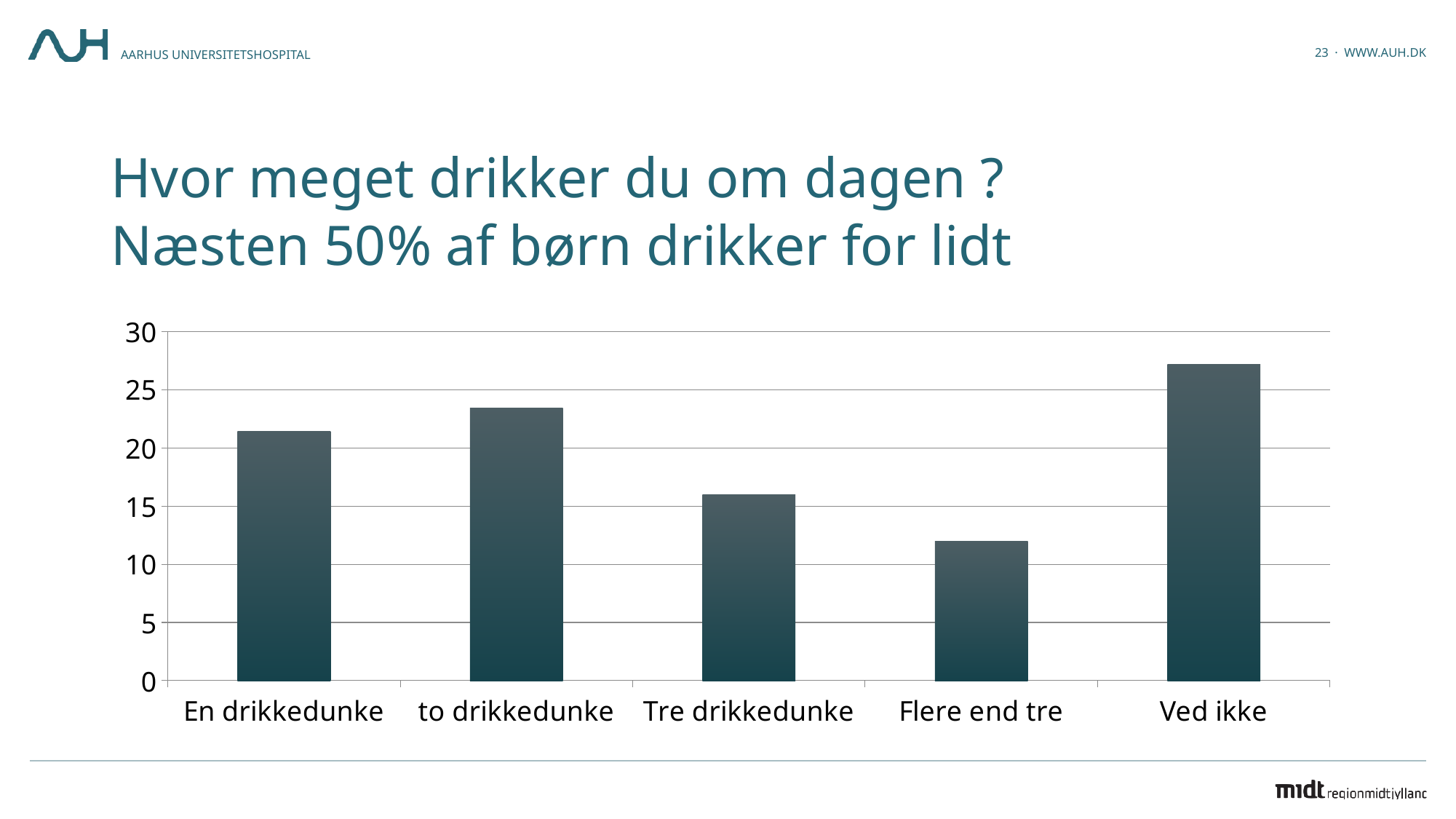
Is the value for Tre drikkedunke greater or less than 20? less Which is larger, the value for Tre drikkedunke or the value for Flere end tre? Tre drikkedunke Is the value for to drikkedunke greater or less than 25? less Which is larger, the value for Ved ikke or the value for En drikkedunke? Ved ikke How many categories are shown on the x axis of the chart? 5 Which category has the highest bar? Ved ikke What kind of chart is shown on the slide? bar chart Is the value for Ved ikke greater or less than 25? greater What is the highest value shown on the y axis of the chart? 30 Which category has the lowest bar? Flere end tre